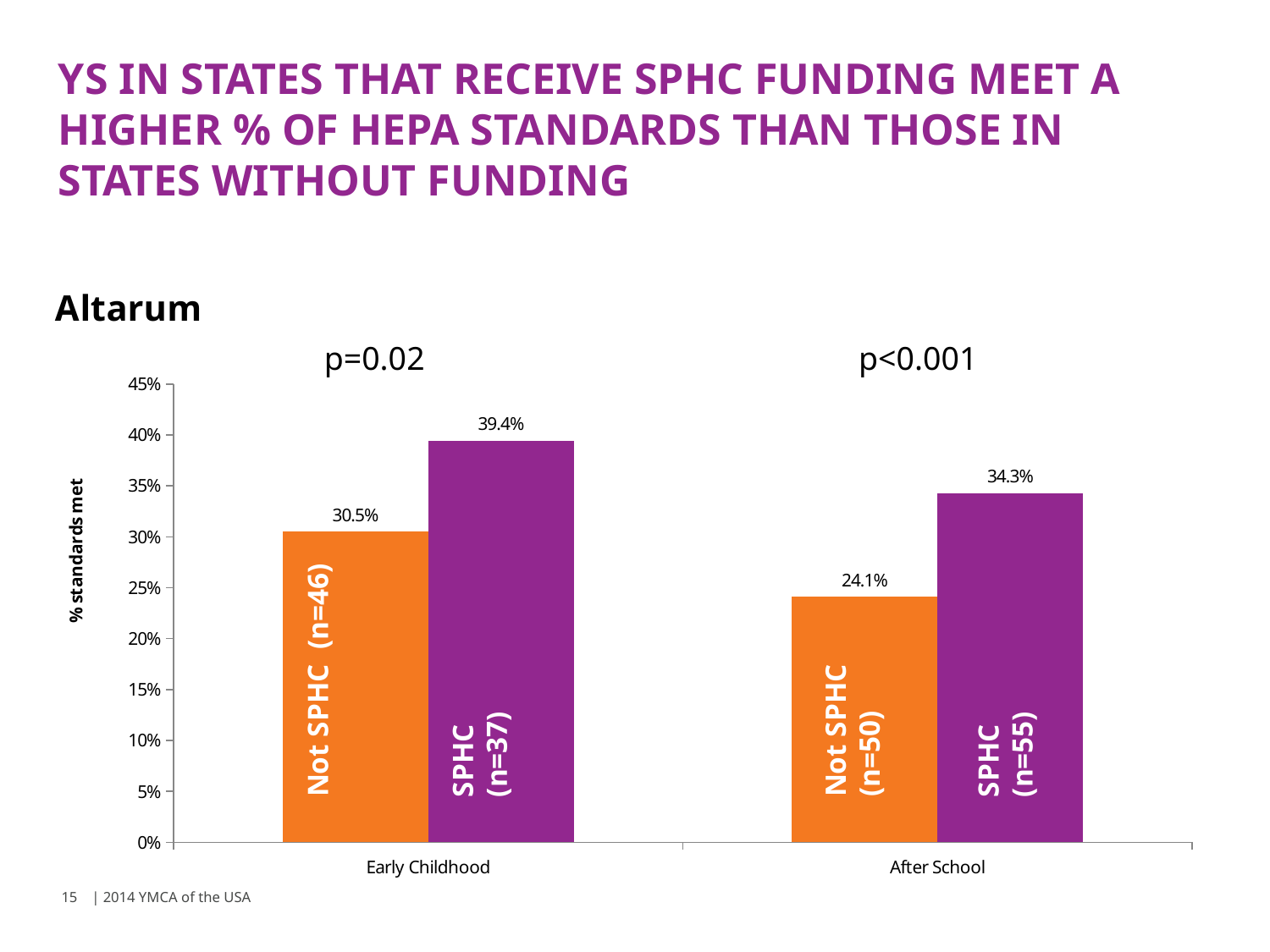
What p-value is shown above the After School group? p<0.001 What percentage of standards is met by Not SPHC (n=46) in the Early Childhood group? 30.5% In the After School group, which is larger: the SPHC bar or the Not SPHC bar? SPHC Which bar shows the highest % of standards met? SPHC (n=37), Early Childhood What is the difference in % standards met between SPHC and Not SPHC in the After School group? 10.2% What percentage of standards is met by SPHC (n=37) in the Early Childhood group? 39.4% What is the difference in % standards met between SPHC and Not SPHC in the Early Childhood group? 8.9% What percentage of standards is met by SPHC (n=55) in the After School group? 34.3% What percentage of standards is met by Not SPHC (n=50) in the After School group? 24.1% What kind of chart is shown on the slide? Bar chart How many groups are shown on the x axis? 2 Which bar shows the lowest % of standards met? Not SPHC (n=50), After School